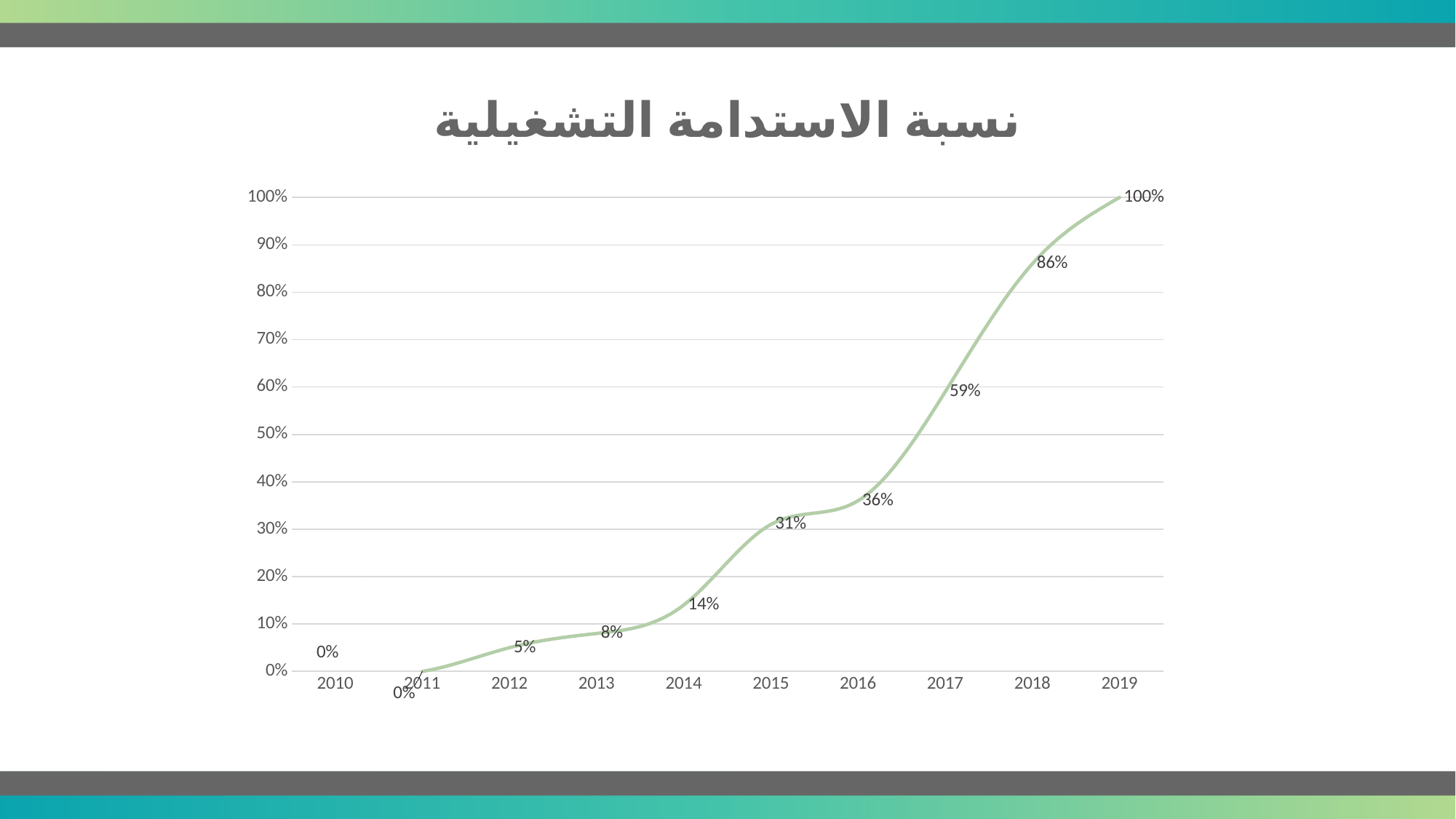
Which is larger, the value for 2014 or the value for 2015? 2015 Do the values rise or fall from 2010 to 2019? rise What is the difference between the values for 2019 and 2018? 14% What is the value for 2013? 8% What is the value for 2018? 86% Is the value for 2017 greater or less than 50%? greater How many years are plotted on the x axis? 10 What is the title of the chart? نسبة الاستدامة التشغيلية Which year has the highest value? 2019 What is the difference between the values for 2017 and 2016? 23% What kind of chart is shown? line chart What is the value for 2015? 31%